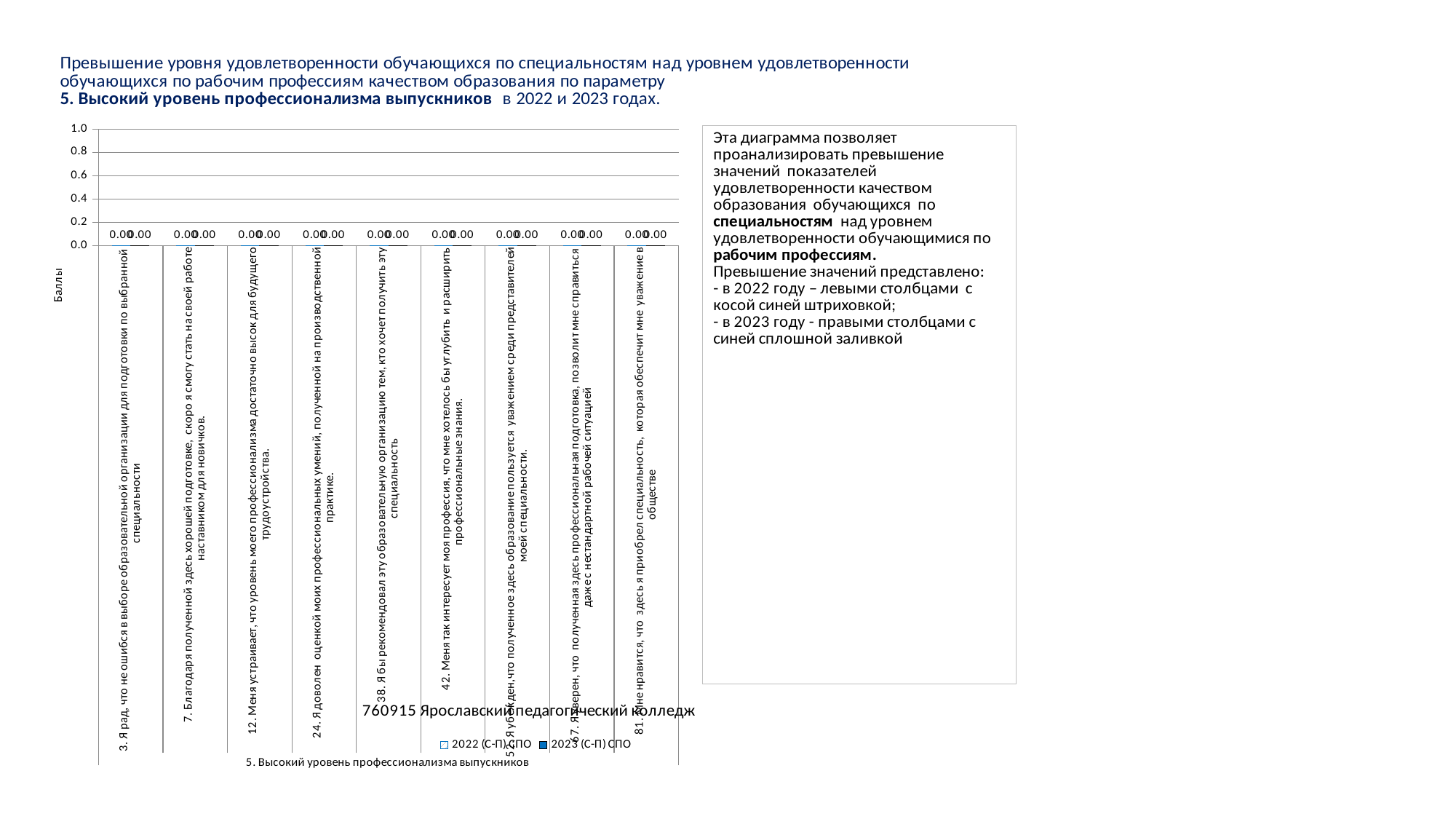
What is the value for the 2023 (С-П) СПО series for category 81 ("Мне нравится, что здесь я приобрел специальность...")? 0.00 How many categories are plotted along the x axis? 9 What are the two legend entries of the chart? 2022 (С-П) СПО and 2023 (С-П) СПО Is the value for the 2023 (С-П) СПО series for category 24 greater or less than 0.2? less What is the value for the 2022 (С-П) СПО series for category 3 ("Я рад, что не ошибся в выборе образовательной организации...")? 0.00 What is the value for the 2022 (С-П) СПО series for category 42 ("Меня так интересует моя профессия...")? 0.00 What is the label of the vertical axis? Баллы What kind of chart is shown on the slide? bar chart What is the difference between the 2022 (С-П) СПО and 2023 (С-П) СПО values for category 12 ("Меня устраивает, что уровень моего профессионализма...")? 0.00 What is the highest value shown on the vertical axis? 1.0 How many series does the legend list? 2